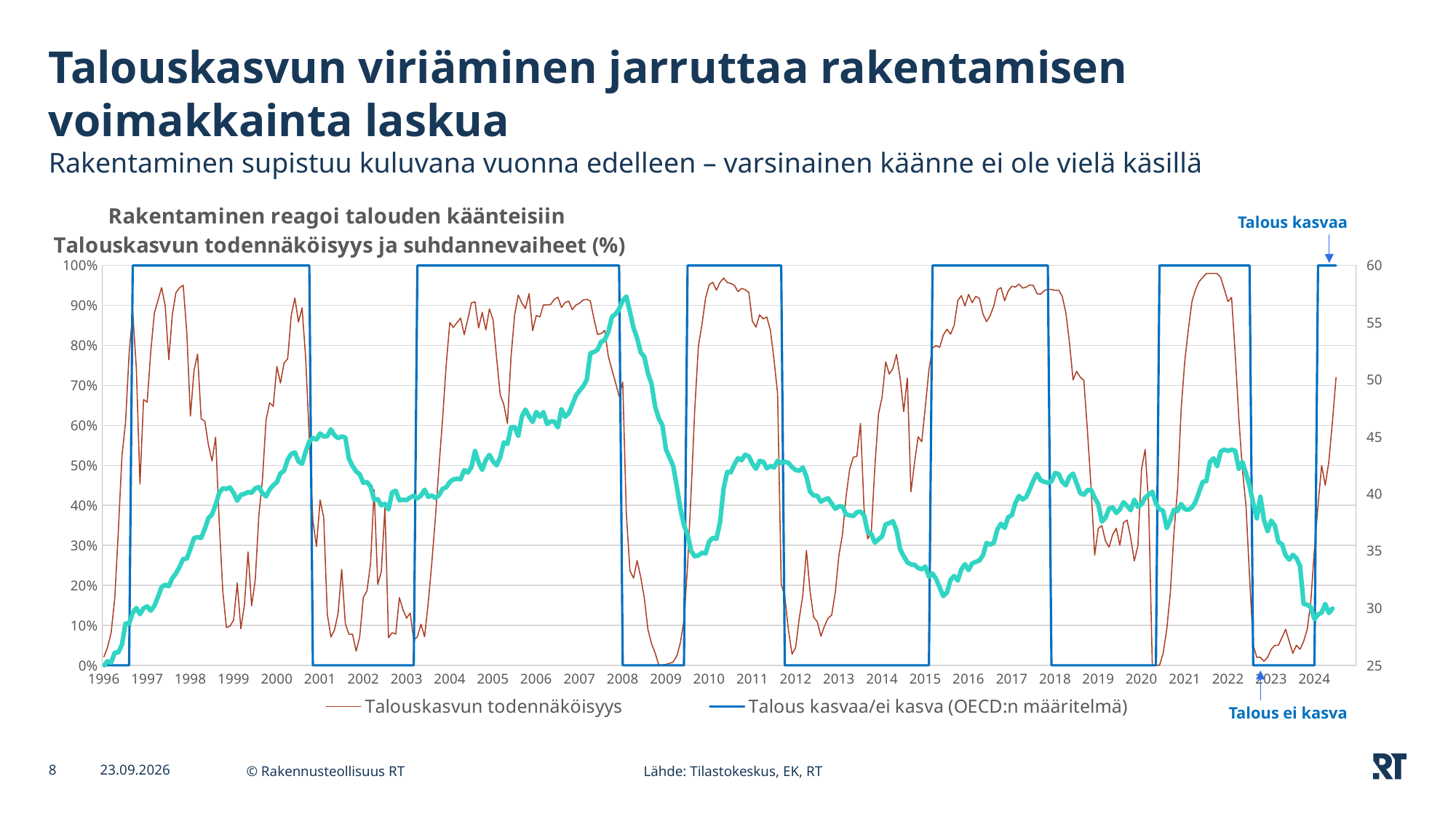
Does the Talouskasvun todennäköisyys line rise or fall between 2022 and 2023? fall What is the highest value shown on the left y axis? 100% What is the highest value shown on the right y axis? 60 What is the first year labelled on the x axis? 1996 What is the title printed above the chart? Rakentaminen reagoi talouden käänteisiin Talouskasvun todennäköisyys ja suhdannevaiheet (%) What is the last year labelled on the x axis? 2024 Is the value of the Talouskasvun todennäköisyys line in 2009 greater or less than 10%? less What kind of chart is shown on the slide? line chart Is the value of the Talouskasvun todennäköisyys line in 2016 greater or less than 80%? greater Is the value of the Talous kasvaa/ei kasva line in 2021 greater or less than 50%? greater How many series does the chart's legend list? 2